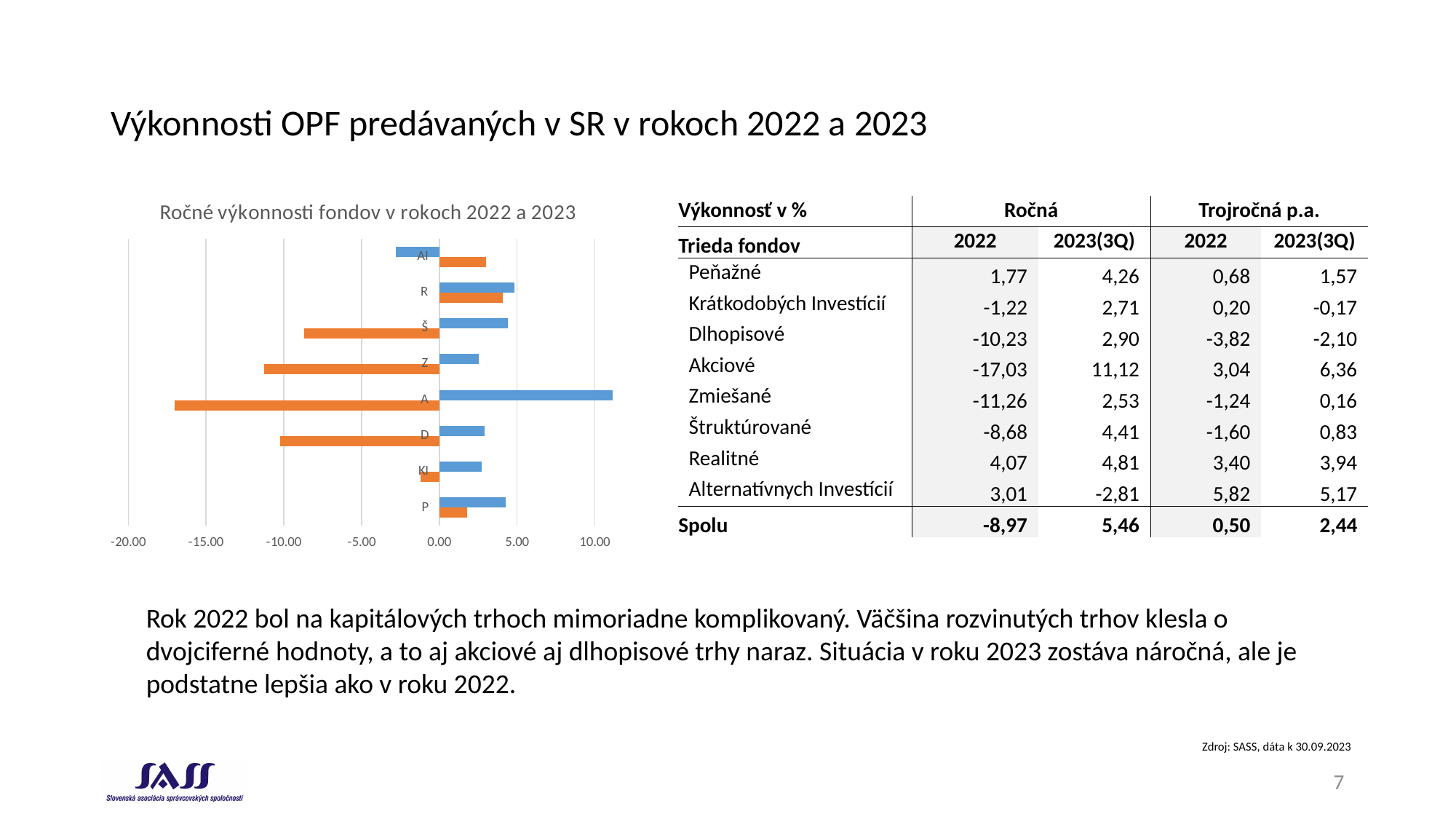
Is the orange bar for category A greater or less than -15.00? less How many data series (bar colours) are plotted for each category in the chart? 2 Which category has the lowest (most negative) orange bar in the chart? A Is the orange bar for category Z greater or less than -10.00? less Which is larger in the chart: the orange bar for R or the orange bar for P? R Which category has the longest blue bar in the chart? A How many categories are plotted on the chart's vertical axis? 8 Is the orange bar for category D greater or less than -5.00? less What is the title of the chart on the slide? Ročné výkonnosti fondov v rokoch 2022 a 2023 What kind of chart is shown on the slide? bar chart Which is larger in the chart: the blue bar for A or the blue bar for R? A